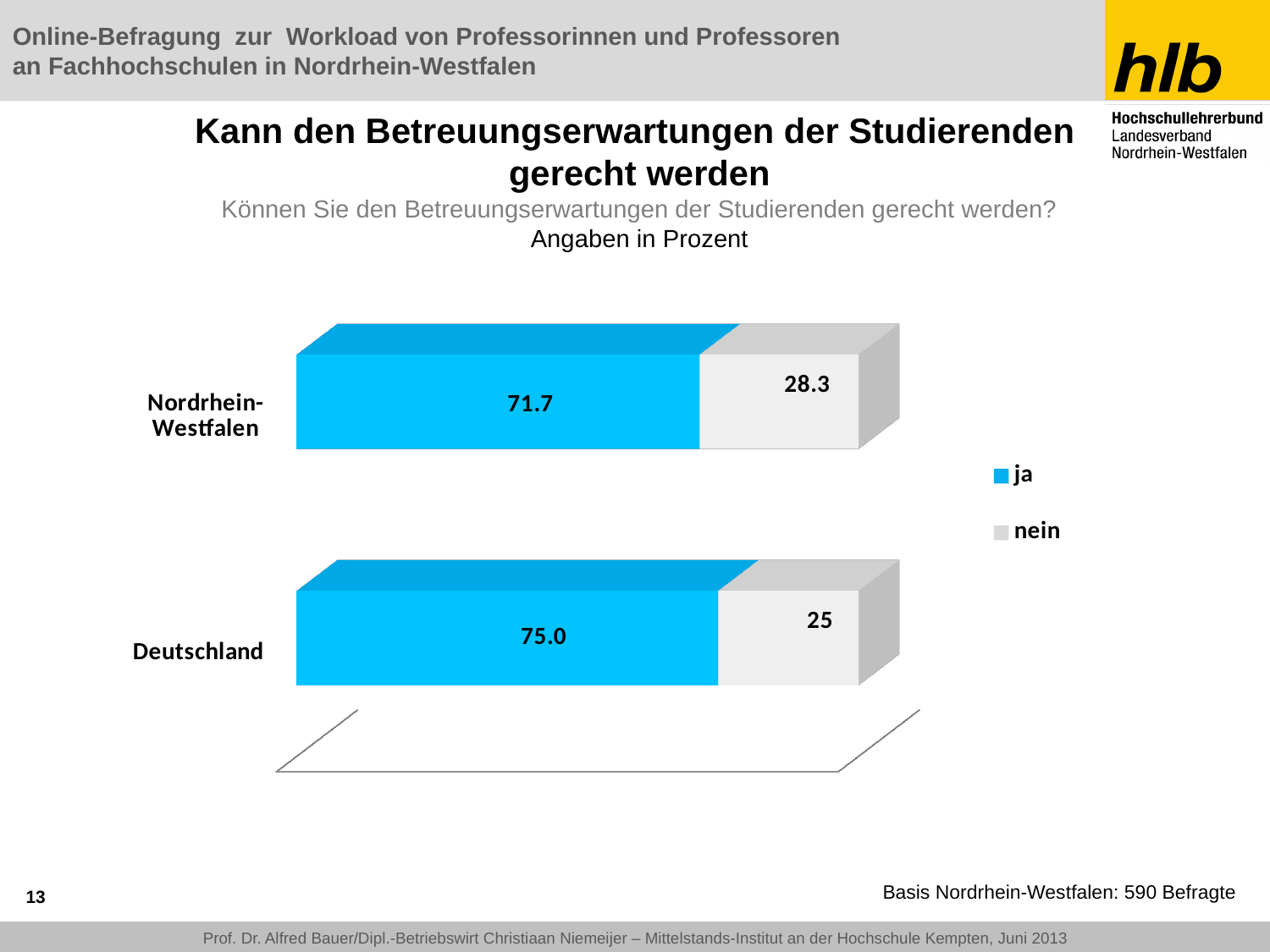
What is the value for "nein" for Deutschland? 25 Which series is shown in blue in the legend? ja What is the difference between the "ja" values for Deutschland and Nordrhein-Westfalen? 3.3 What kind of chart is shown on the slide? Stacked bar chart What is the value for "nein" for Nordrhein-Westfalen? 28.3 What is the total of the stacked bar for Nordrhein-Westfalen? 100 What is the value for "ja" for Nordrhein-Westfalen? 71.7 Which category has the higher "nein" value, Nordrhein-Westfalen or Deutschland? Nordrhein-Westfalen How many series does the legend list? 2 What is the value for "ja" for Deutschland? 75.0 Which category has the higher "ja" value, Nordrhein-Westfalen or Deutschland? Deutschland How many categories are shown in the chart? 2